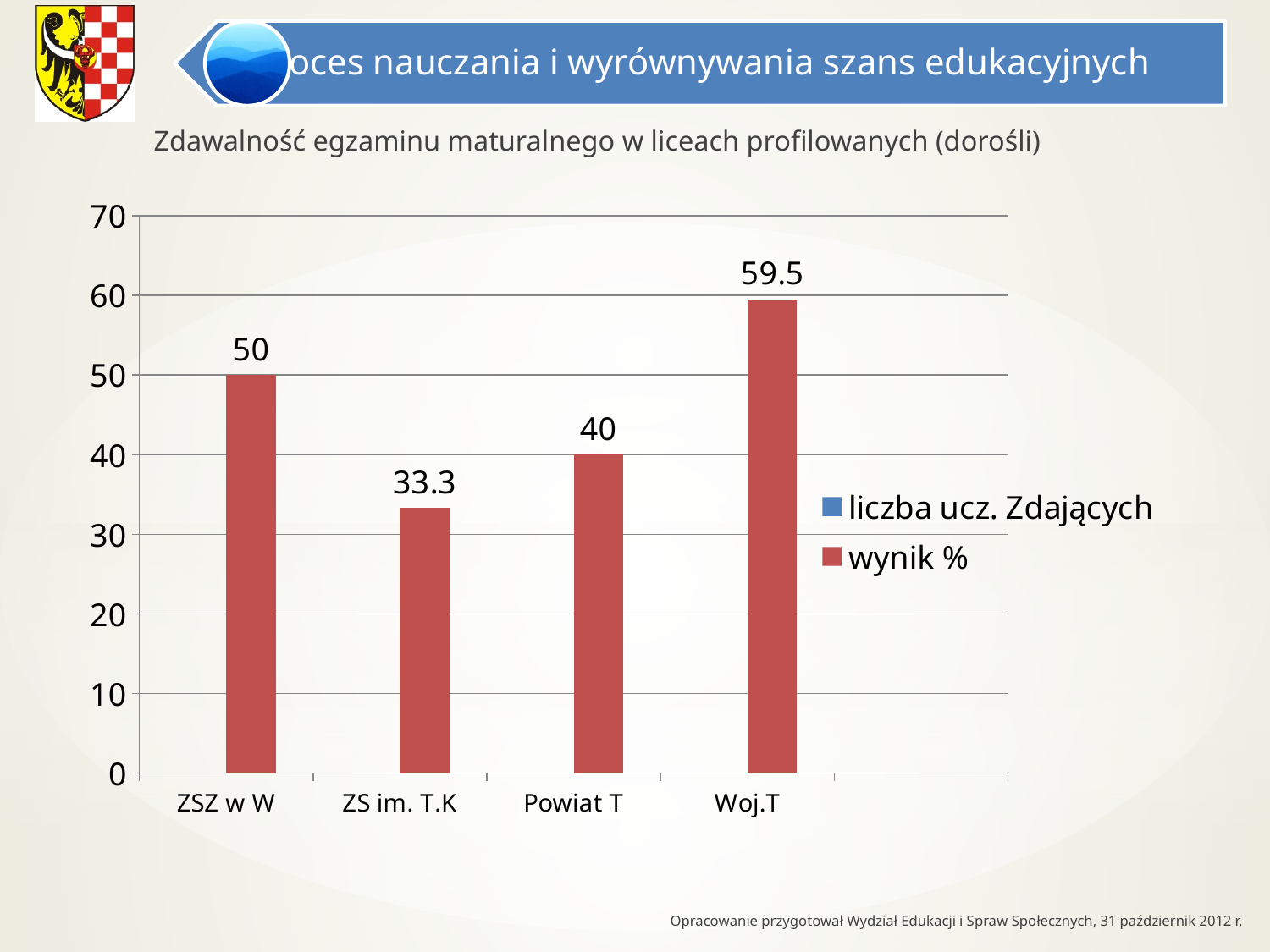
Which is larger, the 'wynik %' value for ZSZ w W or for Powiat T? ZSZ w W What is the 'wynik %' value for Woj.T? 59.5 Which category has the highest 'wynik %' value? Woj.T How many series does the legend list? 2 What kind of chart is shown on the slide? bar chart What is the difference between the 'wynik %' values for Woj.T and ZSZ w W? 9.5 How many categories are shown on the x axis? 4 What is the 'wynik %' value for Powiat T? 40 What is the title of the chart? Zdawalność egzaminu maturalnego w liceach profilowanych (dorośli) Which category has the lowest 'wynik %' value? ZS im. T.K What is the 'wynik %' value for ZSZ w W? 50 What is the 'wynik %' value for ZS im. T.K? 33.3